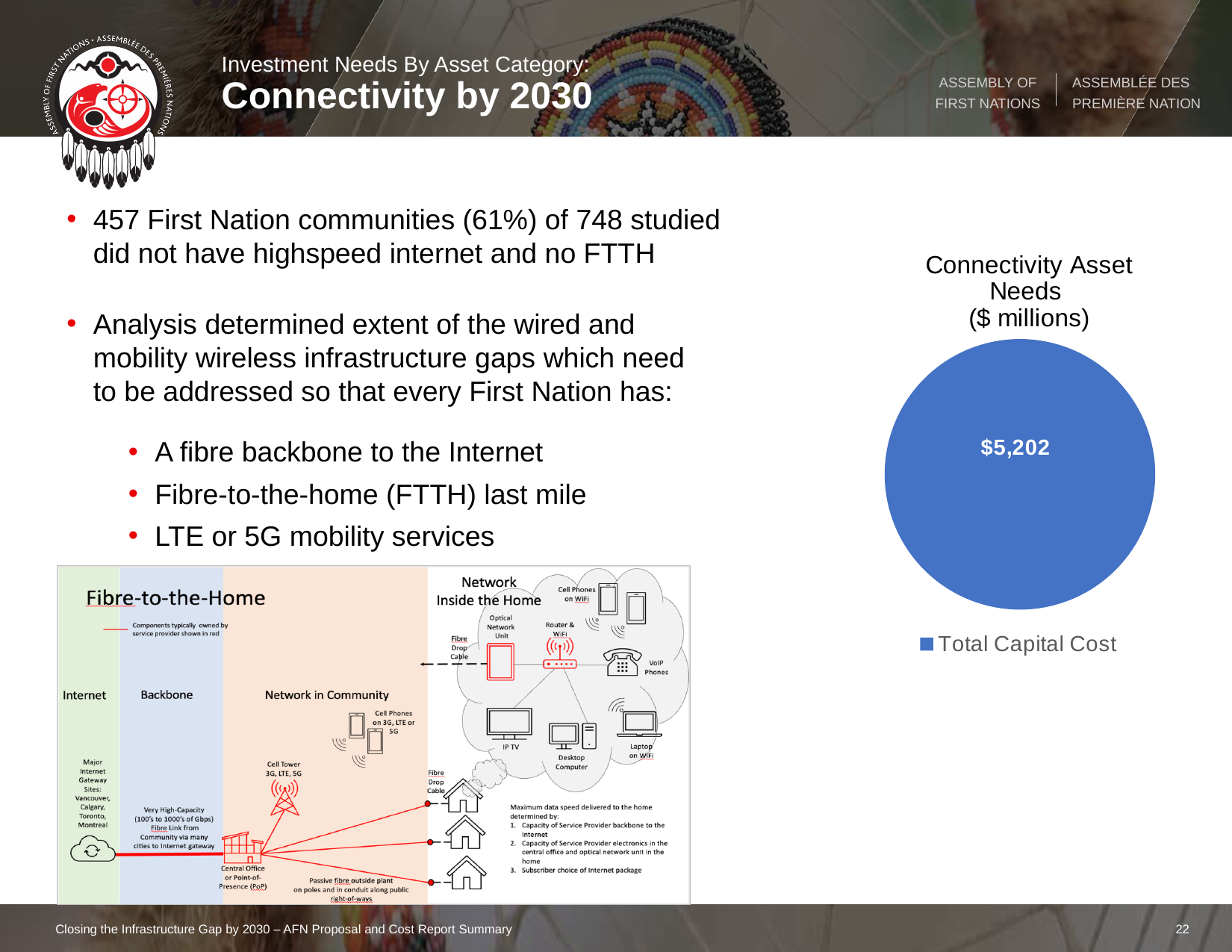
How many slices does the Connectivity Asset Needs pie chart have? 1 How many entries does the legend of the Connectivity Asset Needs chart list? 1 What is the legend entry of the Connectivity Asset Needs pie chart? Total Capital Cost What unit is stated in the title of the Connectivity Asset Needs chart? $ millions What kind of chart is the Connectivity Asset Needs chart? pie chart What is the Total Capital Cost value in the Connectivity Asset Needs chart? $5,202 What share of the Connectivity Asset Needs pie does the Total Capital Cost slice represent? 100% What is the value shown on the Connectivity Asset Needs pie chart? $5,202